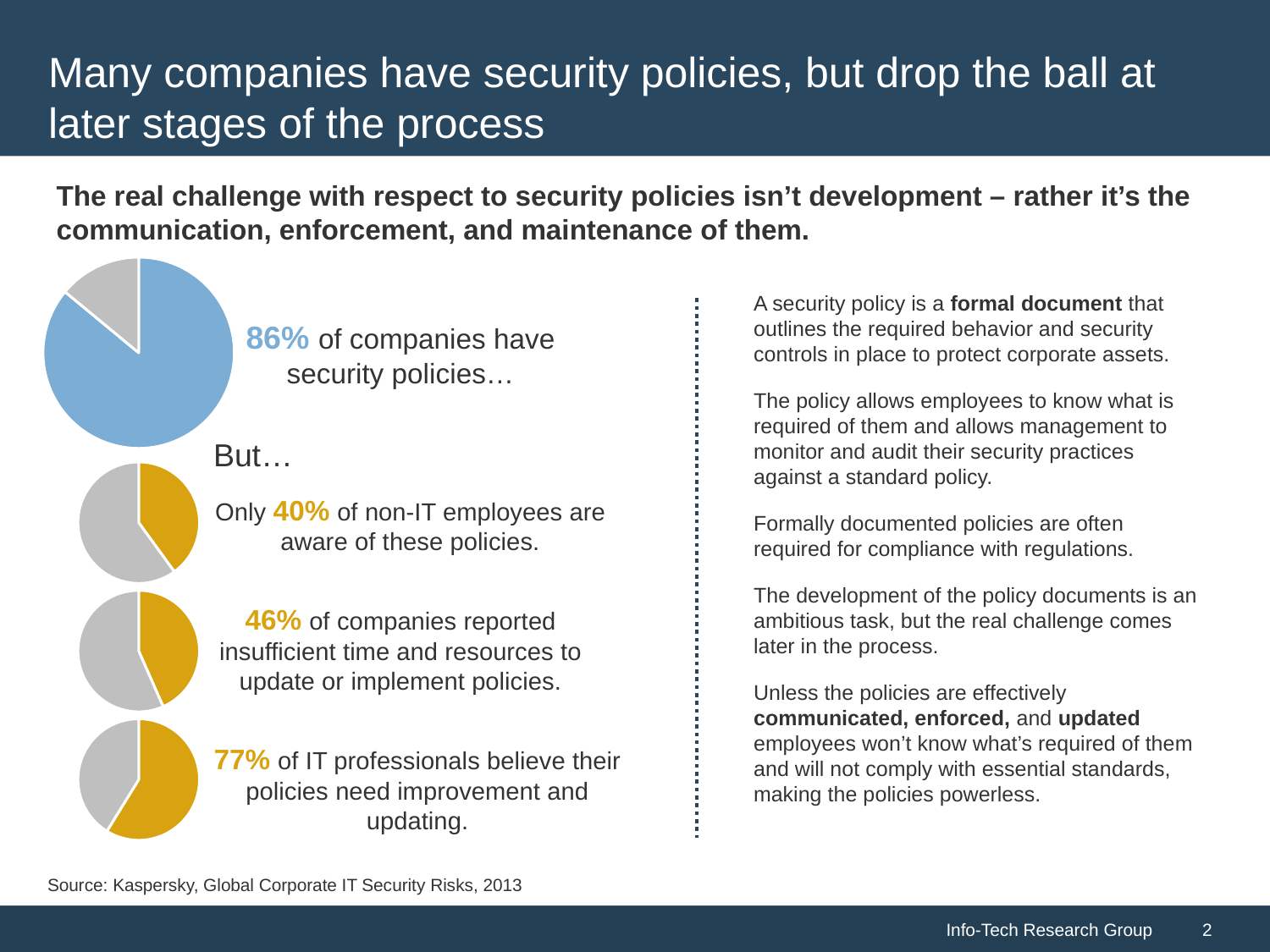
What is the difference in percentage points between the share of companies with security policies (top pie) and the share of non-IT employees aware of them (second pie)? 46 percentage points In the top pie chart, what percentage of companies have security policies? 86% Which is larger: the share of companies that have security policies (top pie) or the share of non-IT employees aware of these policies (second pie)? Companies that have security policies (86%) Across the four pie charts, which highlighted statistic is the highest? 86% of companies have security policies How many pie charts are shown on the slide? 4 What is the difference in percentage points between the bottom pie chart's 77% and the third pie chart's 46%? 31 percentage points In the second pie chart, what percentage of non-IT employees are aware of the security policies? 40% What colour is the highlighted slice in the top pie chart? Blue What kind of chart is used for the top-left chart showing the share of companies with security policies? Pie chart In the third pie chart, what percentage of companies reported insufficient time and resources to update or implement policies? 46% In the bottom pie chart, what percentage of IT professionals believe their policies need improvement and updating? 77% Across the four pie charts, which highlighted statistic is the lowest? 40% of non-IT employees are aware of these policies